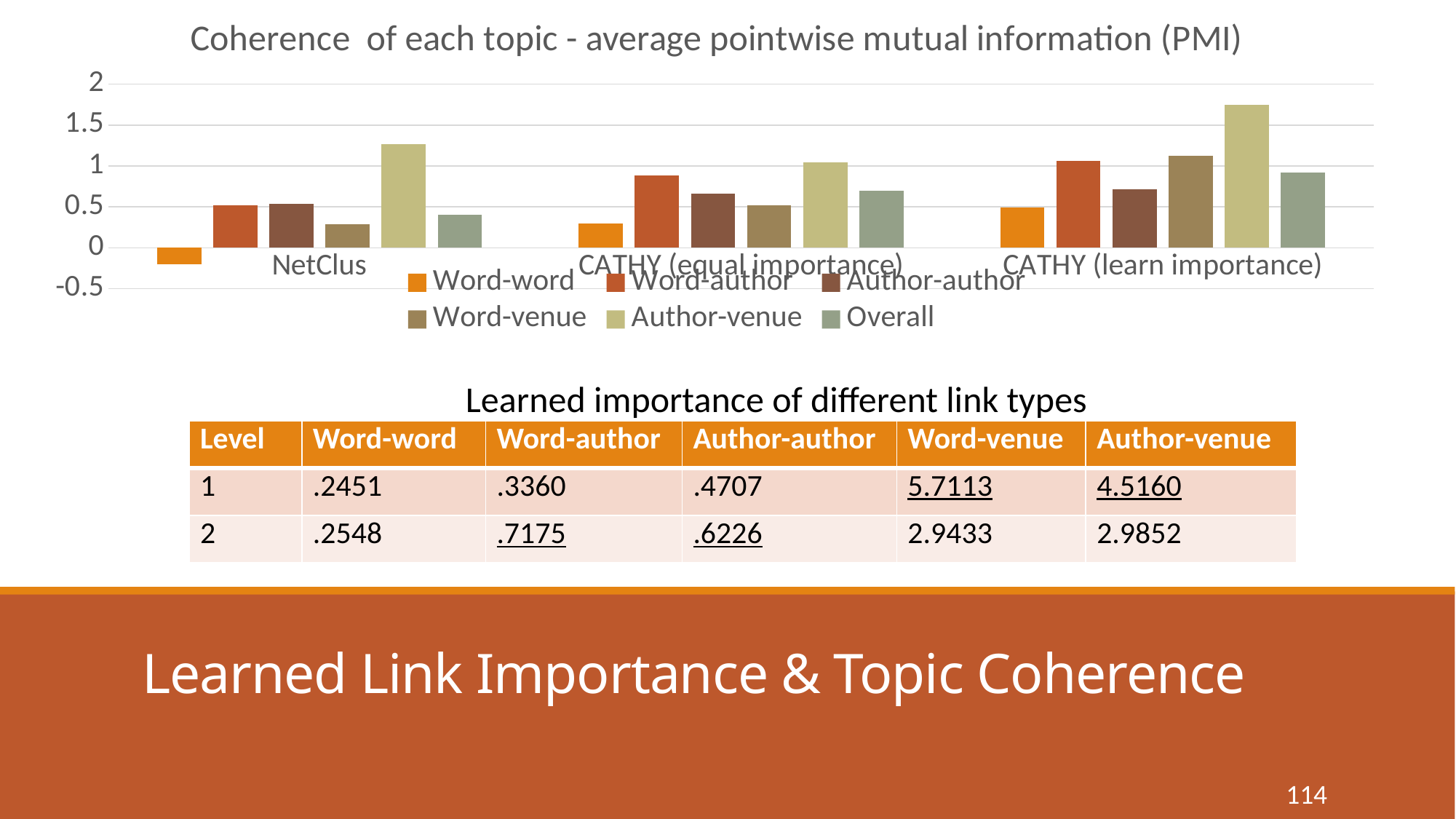
Is the Author-venue value for NetClus greater or less than 1? greater How many series does the chart's legend list? 6 What kind of chart is shown on the slide? bar chart Do the Overall values rise or fall from NetClus to CATHY (learn importance)? rise What is the title of the chart? Coherence of each topic - average pointwise mutual information (PMI) Is the Word-word value for NetClus greater or less than 0? less How many categories are shown on the x axis of the chart? 3 Which is larger, the Overall value for NetClus or for CATHY (learn importance)? CATHY (learn importance) Which category has the lowest Word-word value? NetClus Which category has the highest Author-venue value? CATHY (learn importance) Is the Author-venue value for CATHY (learn importance) greater or less than 1.5? greater Which series has the highest value in the CATHY (equal importance) category? Author-venue